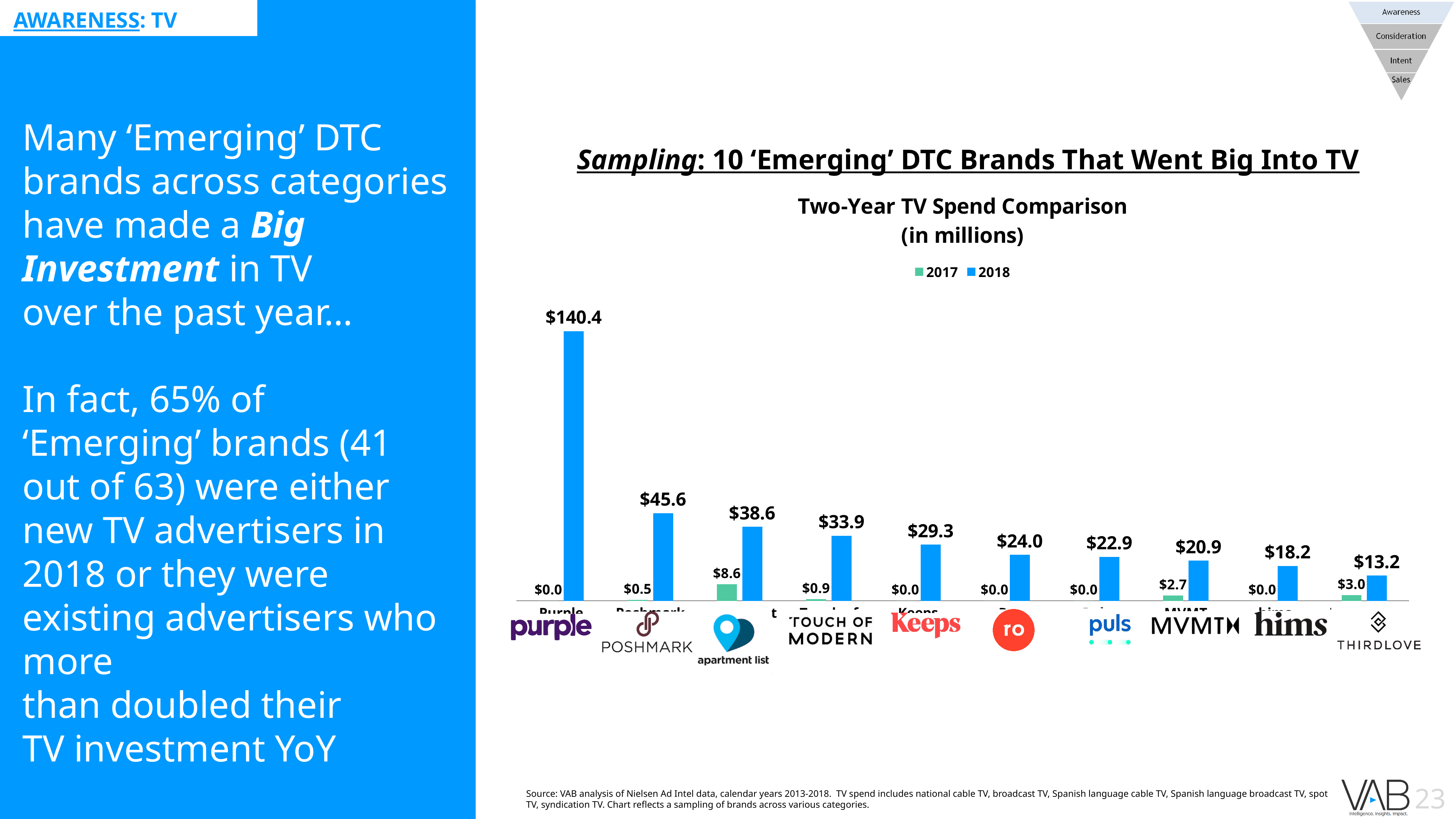
What is the difference between Poshmark's 2018 and 2017 TV spend? $45.1 How many series does the chart's legend list? 2 Which brand had the highest 2018 TV spend in the chart? Purple How many brands are shown in the Two-Year TV Spend Comparison chart? 10 Which years are listed in the chart's legend? 2017 and 2018 Which brand had the lowest 2018 TV spend in the chart? ThirdLove Do the 2018 TV spend values rise or fall moving from left to right across the brands? Fall What was MVMT's 2018 TV spend according to the chart? $20.9 Which brand had a larger 2018 TV spend, Keeps or Ro? Keeps What was Purple's 2018 TV spend in the Two-Year TV Spend Comparison chart? $140.4 What was Apartment List's 2017 TV spend according to the chart? $8.6 What type of chart is the Two-Year TV Spend Comparison? Bar chart